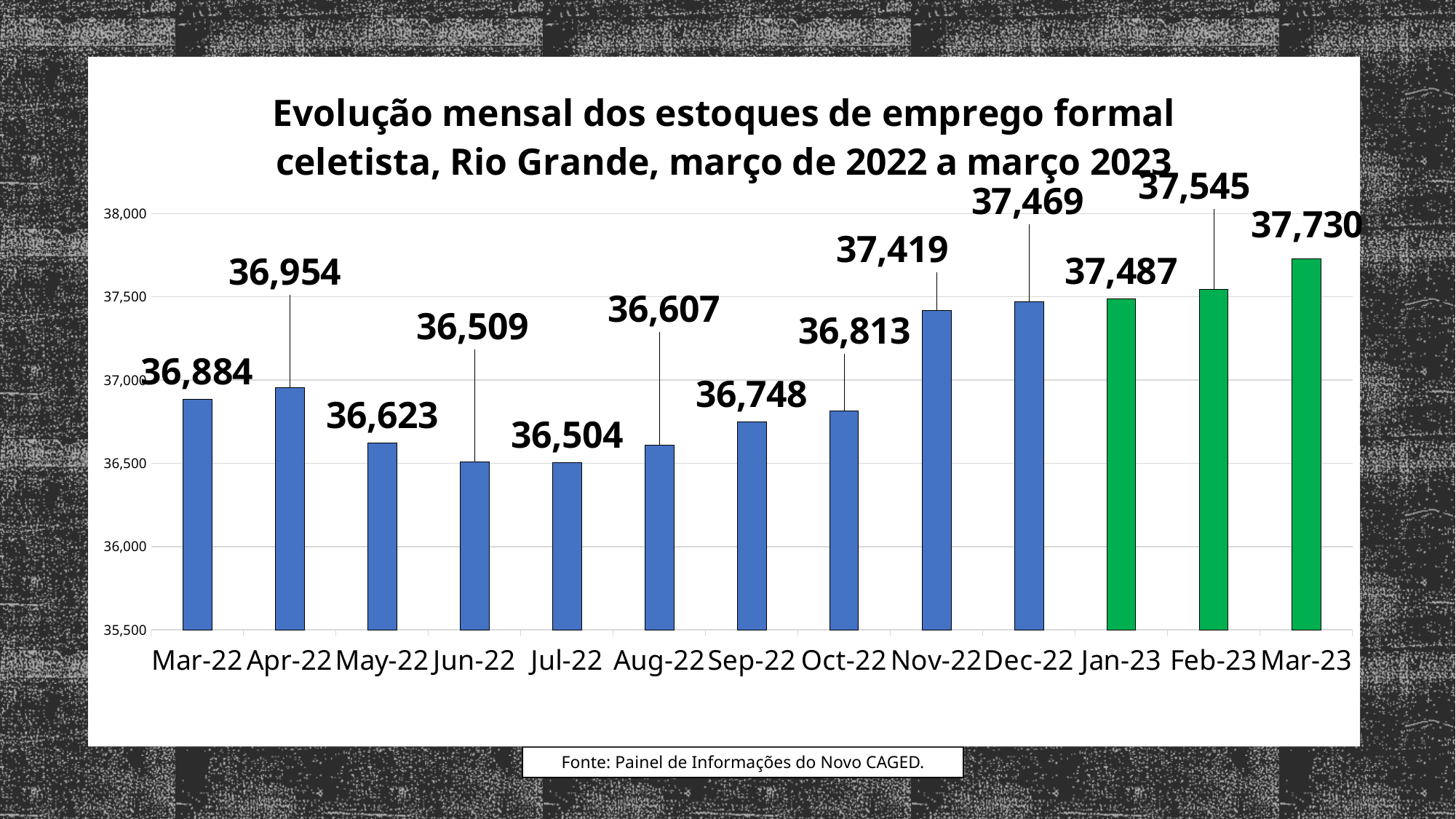
What is the difference between the values for Mar-23 and Mar-22? 846 Which month has the lowest value? Jul-22 What is the value for Jul-22? 36,504 Is the value for Jun-22 greater or less than 37,000? less Which months are shown with green bars? Jan-23, Feb-23, Mar-23 Which is larger, the value for Apr-22 or the value for Oct-22? Apr-22 What is the value for Nov-22? 37,419 What is the difference between the values for Dec-22 and Nov-22? 50 Which month has the highest value? Mar-23 What kind of chart is shown on the slide? bar chart What is the value for Mar-22? 36,884 How many months are shown on the x axis? 13